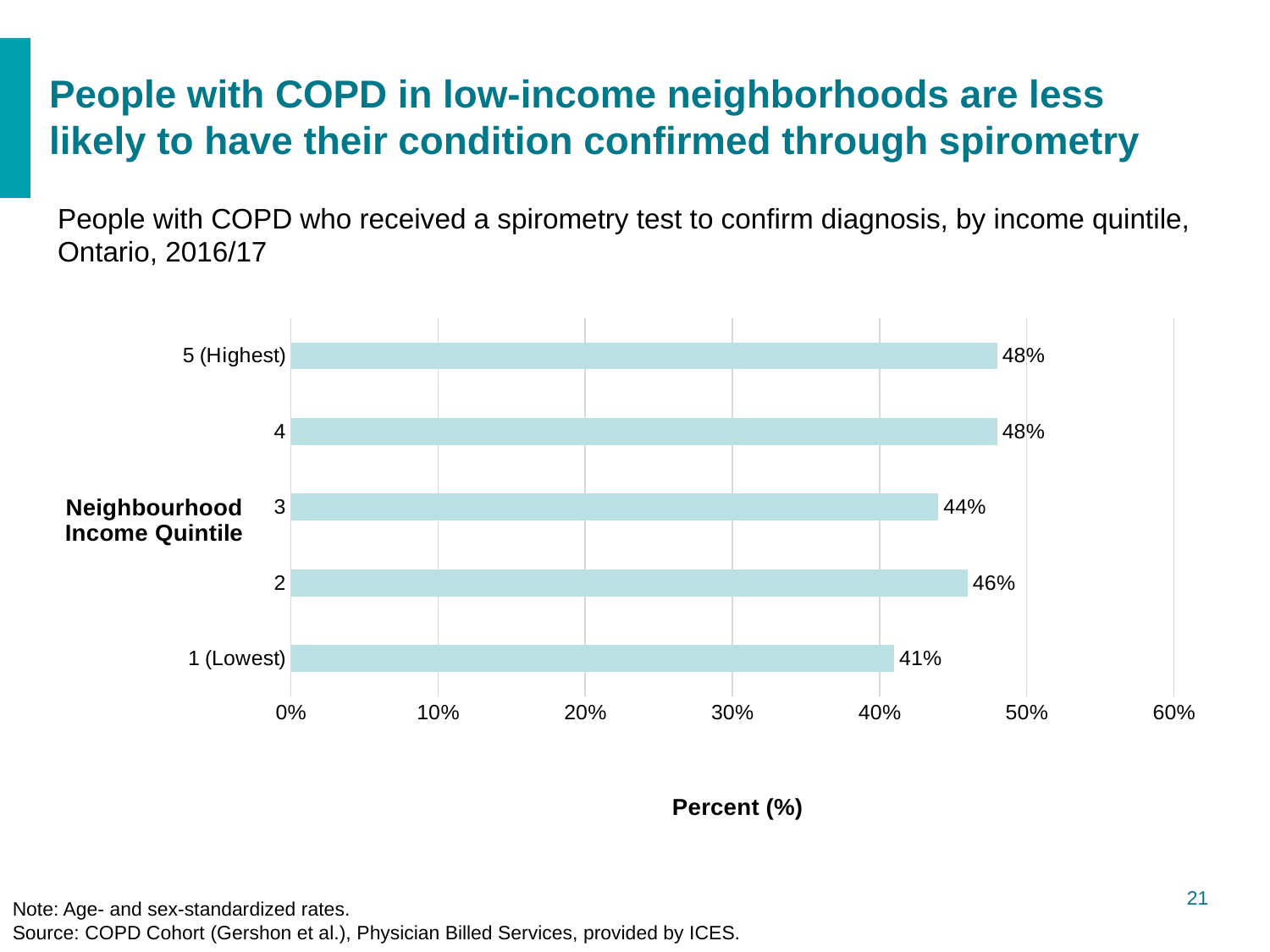
What is the difference between the values for quintile 2 and quintile 3? 2% Is the value for quintile 1 (Lowest) greater or less than 50%? less What is the value shown for income quintile 2? 46% Which income quintile has the lowest percentage of people with COPD who received a spirometry test? 1 (Lowest) What is the difference between the values for quintile 5 (Highest) and quintile 1 (Lowest)? 7% What type of chart is shown on the slide? Bar chart What is the value shown for income quintile 5 (Highest)? 48% Which is larger, the value for quintile 2 or the value for quintile 3? Quintile 2 What is the value shown for income quintile 3? 44% What percentage of people with COPD in income quintile 1 (Lowest) received a spirometry test to confirm diagnosis? 41% How many income quintile categories are shown in the chart? 5 What is the label of the horizontal axis of the chart? Percent (%)